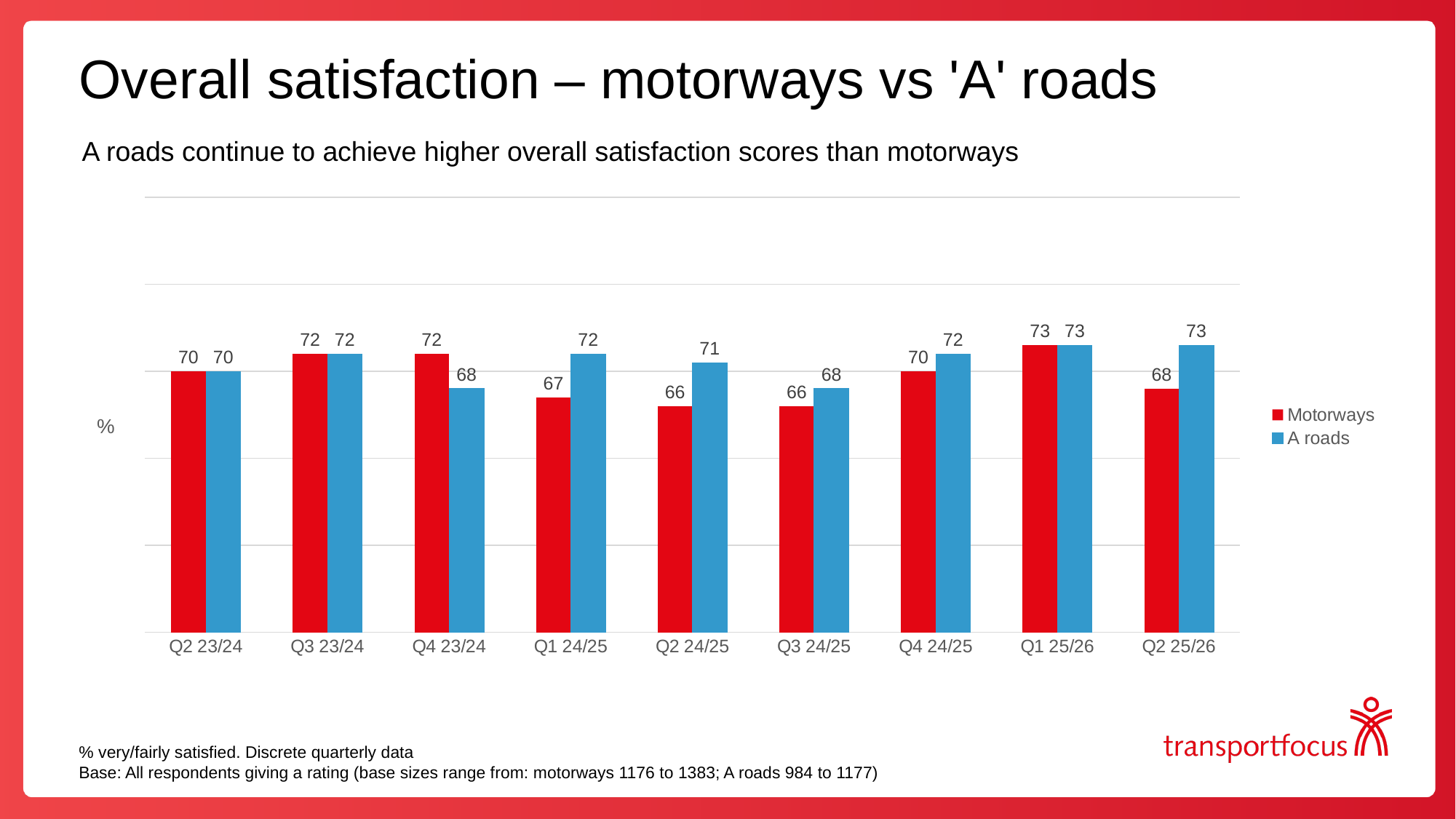
What is the Motorways value for Q2 24/25? 66 In which quarter is the A roads value highest? Q1 25/26 and Q2 25/26 What is the A roads value for Q4 23/24? 68 In which quarter is the Motorways value lowest? Q2 24/25 and Q3 24/25 What is the title of the slide? Overall satisfaction – motorways vs 'A' roads How many series does the legend list? 2 What is the difference between the A roads and Motorways values in Q1 24/25? 5 What colour are the Motorways bars? Red What is the A roads value for Q2 25/26? 73 How many quarters are shown on the x axis? 9 What kind of chart is shown on the slide? Bar chart Which is larger in Q4 23/24, the Motorways value or the A roads value? Motorways